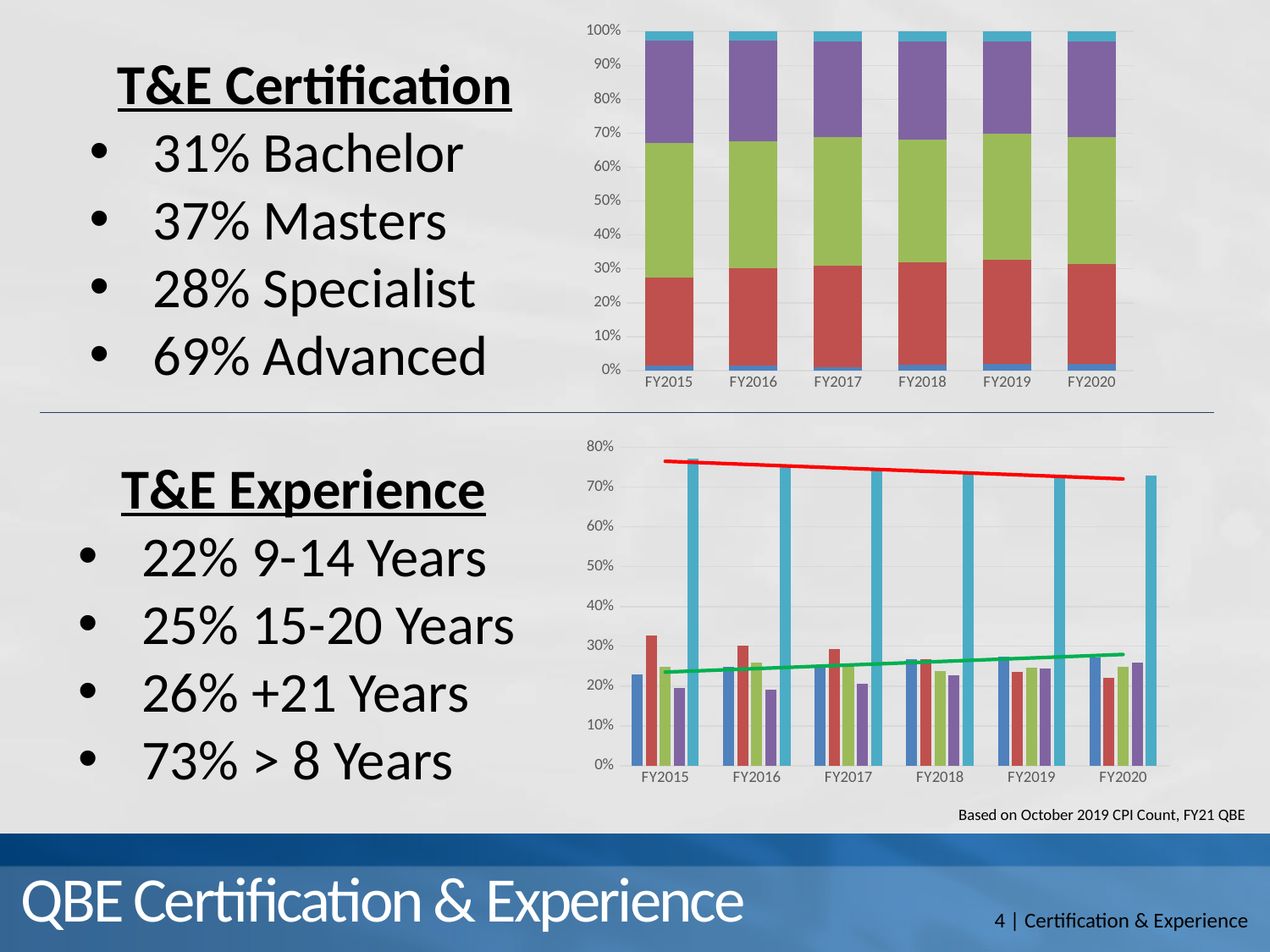
In the top chart, is the top of the green segment for FY2015 greater or less than 70%? less In the bottom chart, do the tall light blue bars rise or fall from FY2015 to FY2020? fall What kind of chart is the top chart on the slide? stacked bar chart In the top chart, is the top of the red segment for FY2015 greater or less than 30%? less In the top chart, how many fiscal years are shown on the x axis? 6 In the bottom chart, is the tallest (light blue) bar for FY2015 greater or less than 70%? greater In the bottom chart, what colours are the two trend lines drawn over the bars? red and green In the bottom chart, how many fiscal years are shown on the x axis? 6 In the bottom chart, which bar is the tallest in the FY2015 group? the light blue bar What kind of chart is the bottom chart on the slide? bar chart